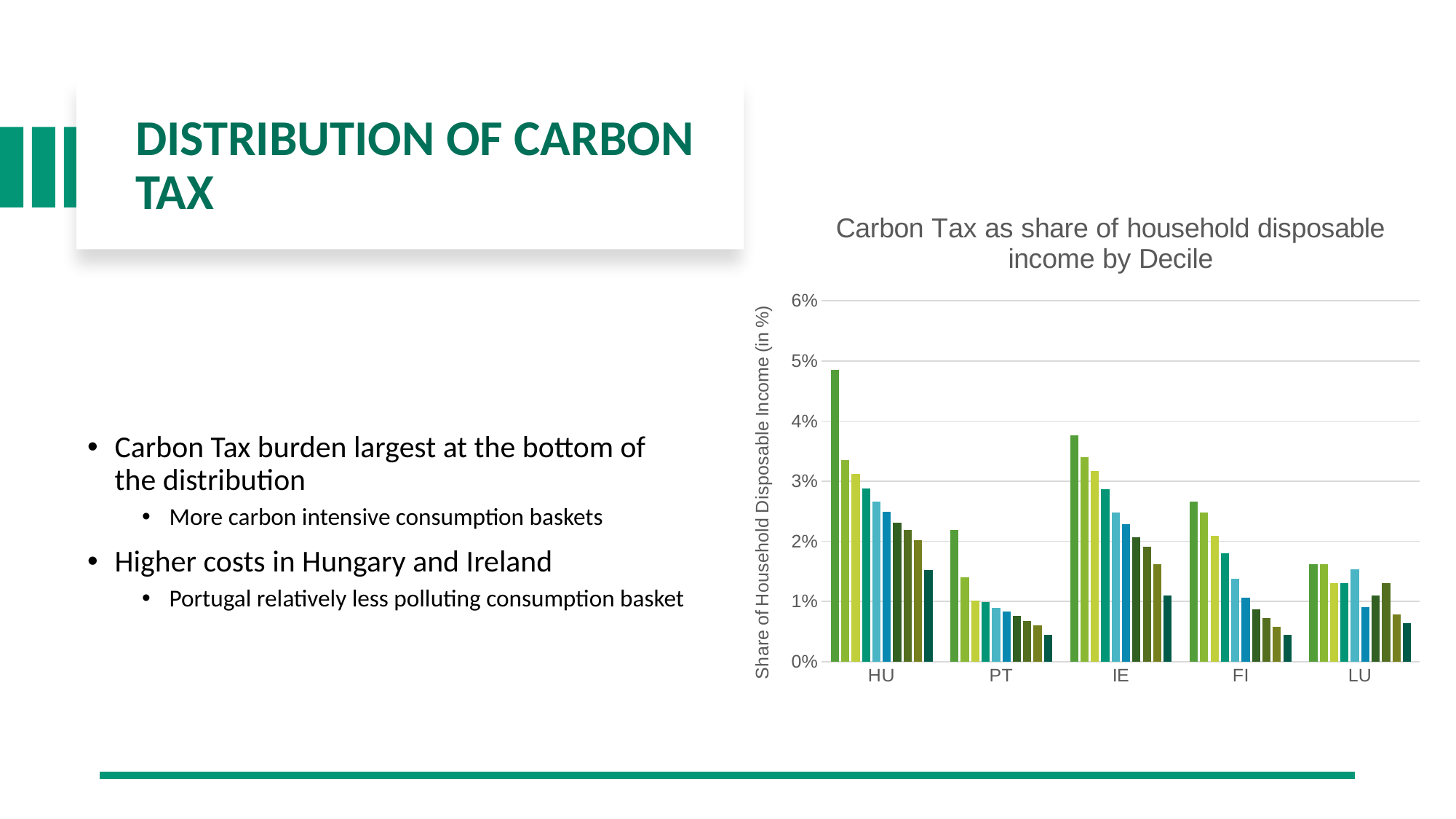
What is the label of the vertical axis of the chart? Share of Household Disposable Income (in %) What kind of chart is shown on the slide? bar chart Is the tallest bar for PT greater or less than 2%? greater What is the title of the chart? Carbon Tax as share of household disposable income by Decile Is the tallest bar for HU greater or less than 4%? greater How many bars are plotted for each country in the chart? 10 Is the tallest bar for LU greater or less than 2%? less How many countries are shown on the x axis of the chart? 5 Within the HU group, do the bars rise or fall from left to right? fall Which country has the tallest bar in the chart? HU Which is larger, the first bar for HU or the first bar for IE? HU